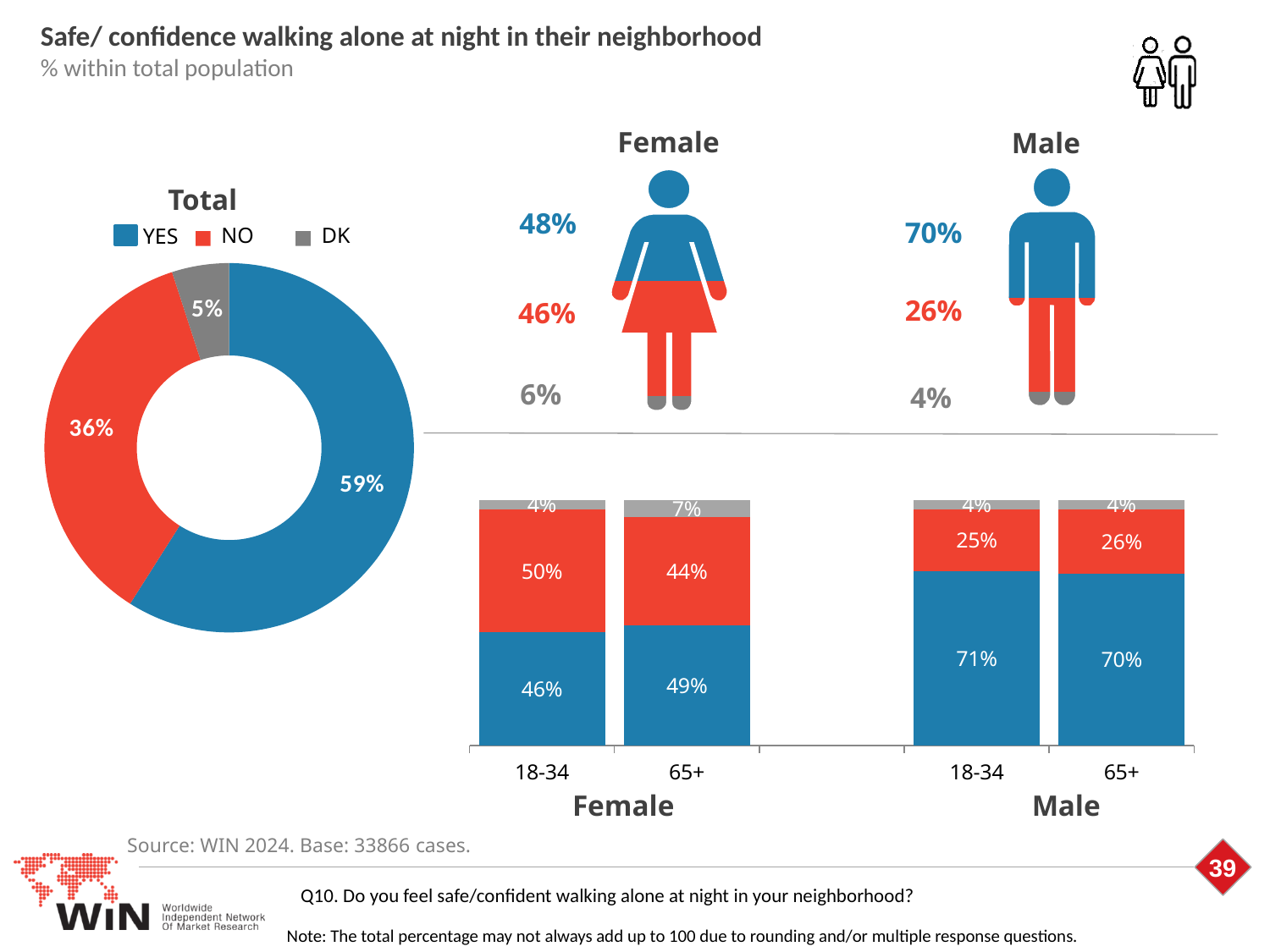
How many bars are shown in the stacked bar chart at the bottom of the slide? 4 In the 'Total' donut chart, which response has the largest share? YES In the stacked bar chart at the bottom, is the NO value larger for Female 18-34 or Female 65+? Female 18-34 In the 'Total' donut chart, what is the difference between the YES and NO shares? 23 percentage points In the stacked bar chart at the bottom, which group has the highest YES value? Male 18-34 In the pictogram figures at the top, what percentage of males answered YES? 70% In the 'Total' donut chart, what percentage answered YES? 59% In the stacked bar chart at the bottom, what is the NO value for Male 65+? 26% What kind of chart is the 'Total' chart on the left of the slide? Donut (pie) chart In the 'Total' donut chart, what percentage answered DK? 5% In the stacked bar chart at the bottom, what is the YES value for Female 18-34? 46% How many series does the legend of the 'Total' donut chart list? 3